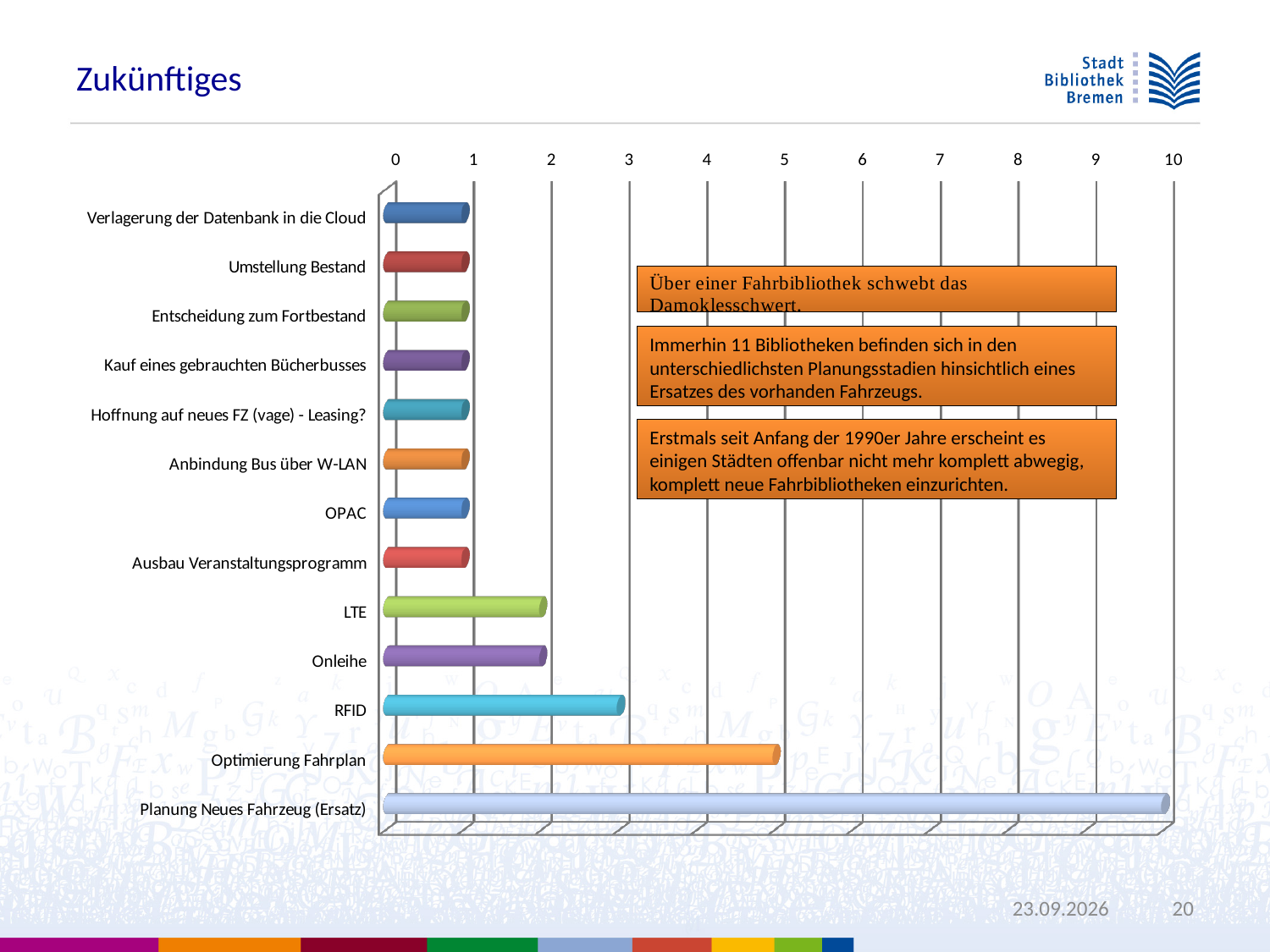
Which has the larger value, Optimierung Fahrplan or RFID? Optimierung Fahrplan Which has the larger value, RFID or Onleihe? RFID Is the value for RFID greater or less than 4? less Is the value for LTE greater or less than 1? greater Is the value for Optimierung Fahrplan greater or less than 4? greater Which has the larger value, Planung Neues Fahrzeug (Ersatz) or Optimierung Fahrplan? Planung Neues Fahrzeug (Ersatz) What is the highest value shown on the chart's horizontal axis? 10 What kind of chart is shown on the slide? bar chart Which category has the highest value in the bar chart? Planung Neues Fahrzeug (Ersatz) How many categories are plotted in the bar chart? 13